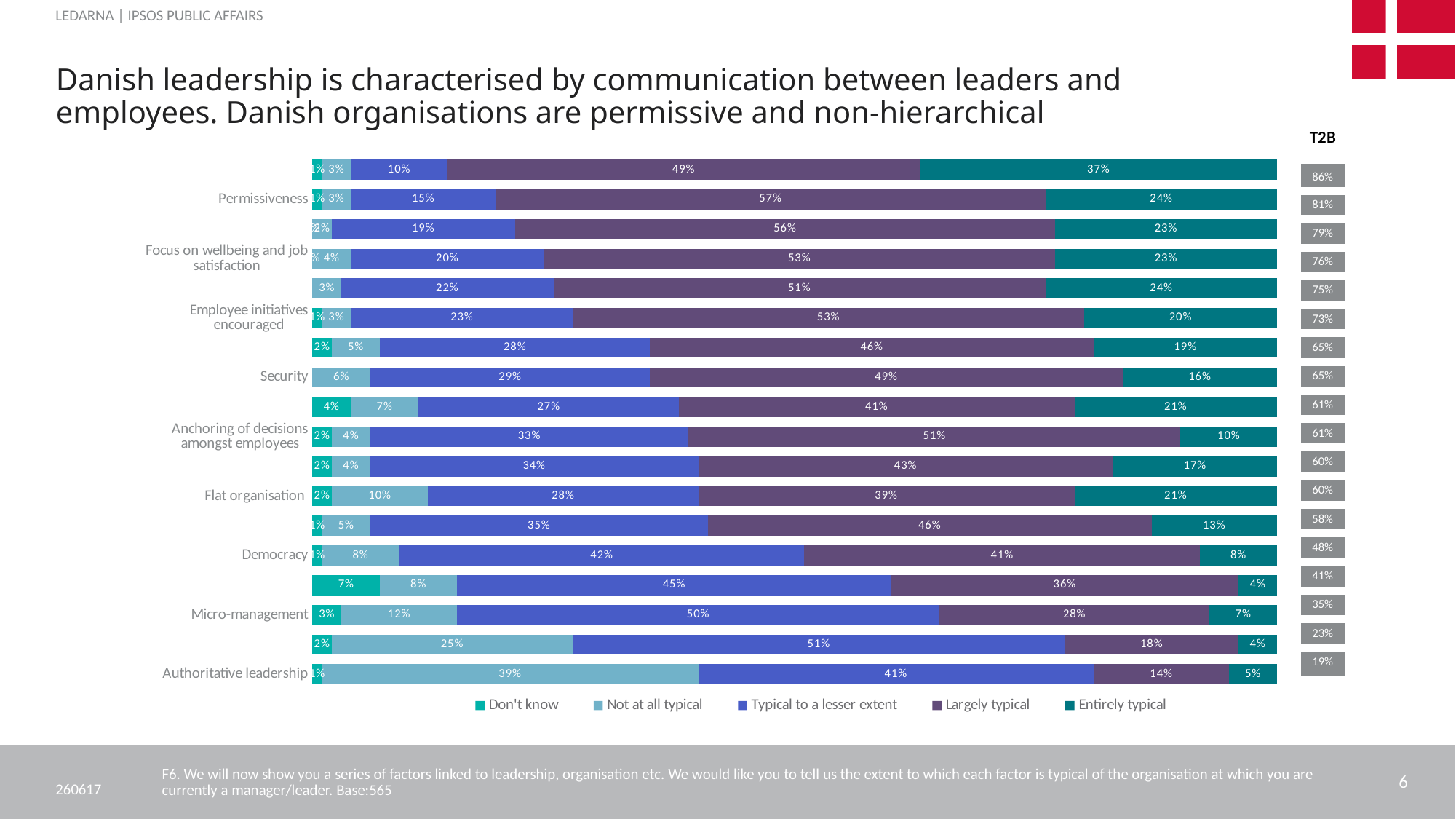
What is the 'Typical to a lesser extent' value for Democracy? 42% For Authoritative leadership, which is larger: the 'Not at all typical' value or the 'Typical to a lesser extent' value? Typical to a lesser extent Which series has the largest segment in the Micro-management bar? Typical to a lesser extent What is the 'Entirely typical' value for Flat organisation? 21% What kind of chart is shown on the slide? Stacked bar chart Which legend entry is listed first? Don't know What is the 'Largely typical' value for Security? 49% What is the total of the Authoritative leadership stacked bar? 100% What is the 'Typical to a lesser extent' value for Micro-management? 50% For Permissiveness, what is the difference between the 'Largely typical' value and the 'Entirely typical' value? 33 percentage points What is the 'Not at all typical' value for Authoritative leadership? 39% How many series does the legend list? 5